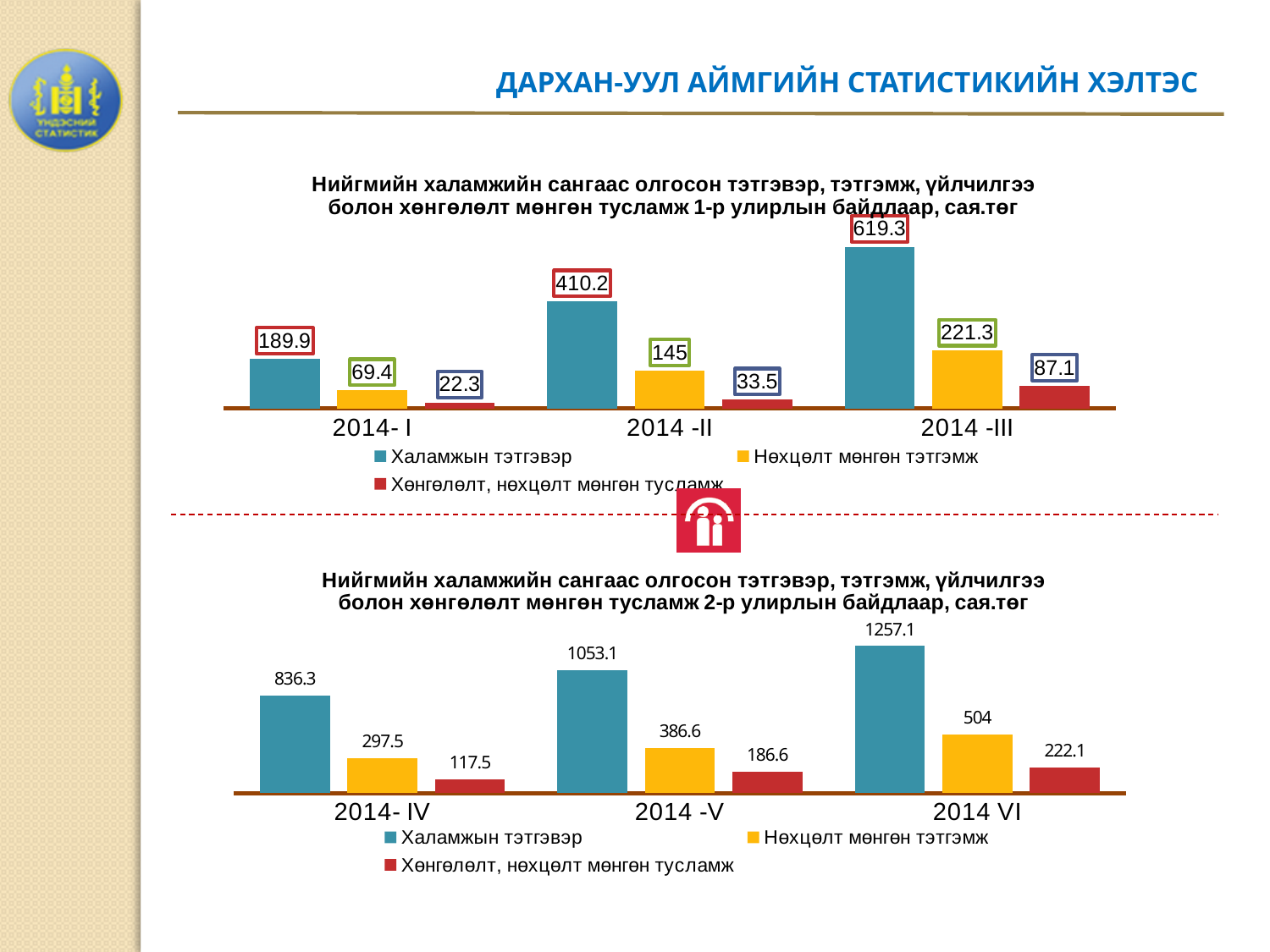
In the bottom chart, what is the value of Нөхцөлт мөнгөн тэтгэмж for 2014- IV? 297.5 In the bottom chart, which category has the lowest value for Хөнгөлөлт, нөхцөлт мөнгөн тусламж? 2014- IV In the top chart, what is the difference between Халамжын тэтгэвэр for 2014 -III and 2014 -II? 209.1 In the bottom chart, does Халамжын тэтгэвэр rise or fall from 2014- IV to 2014 VI? rise In the top chart, what is the value of Нөхцөлт мөнгөн тэтгэмж for 2014 -III? 221.3 What kind of chart is the bottom chart? bar chart In the top chart, how many series does the legend list? 3 In the top chart, what is the value of Халамжын тэтгэвэр for 2014 -II? 410.2 In the bottom chart, what is the value of Халамжын тэтгэвэр for 2014 VI? 1257.1 In the bottom chart, what is the difference between Нөхцөлт мөнгөн тэтгэмж for 2014 VI and 2014 -V? 117.4 In the top chart, what is the value of Хөнгөлөлт, нөхцөлт мөнгөн тусламж for 2014- I? 22.3 In the top chart, which category has the highest value for Халамжын тэтгэвэр? 2014 -III